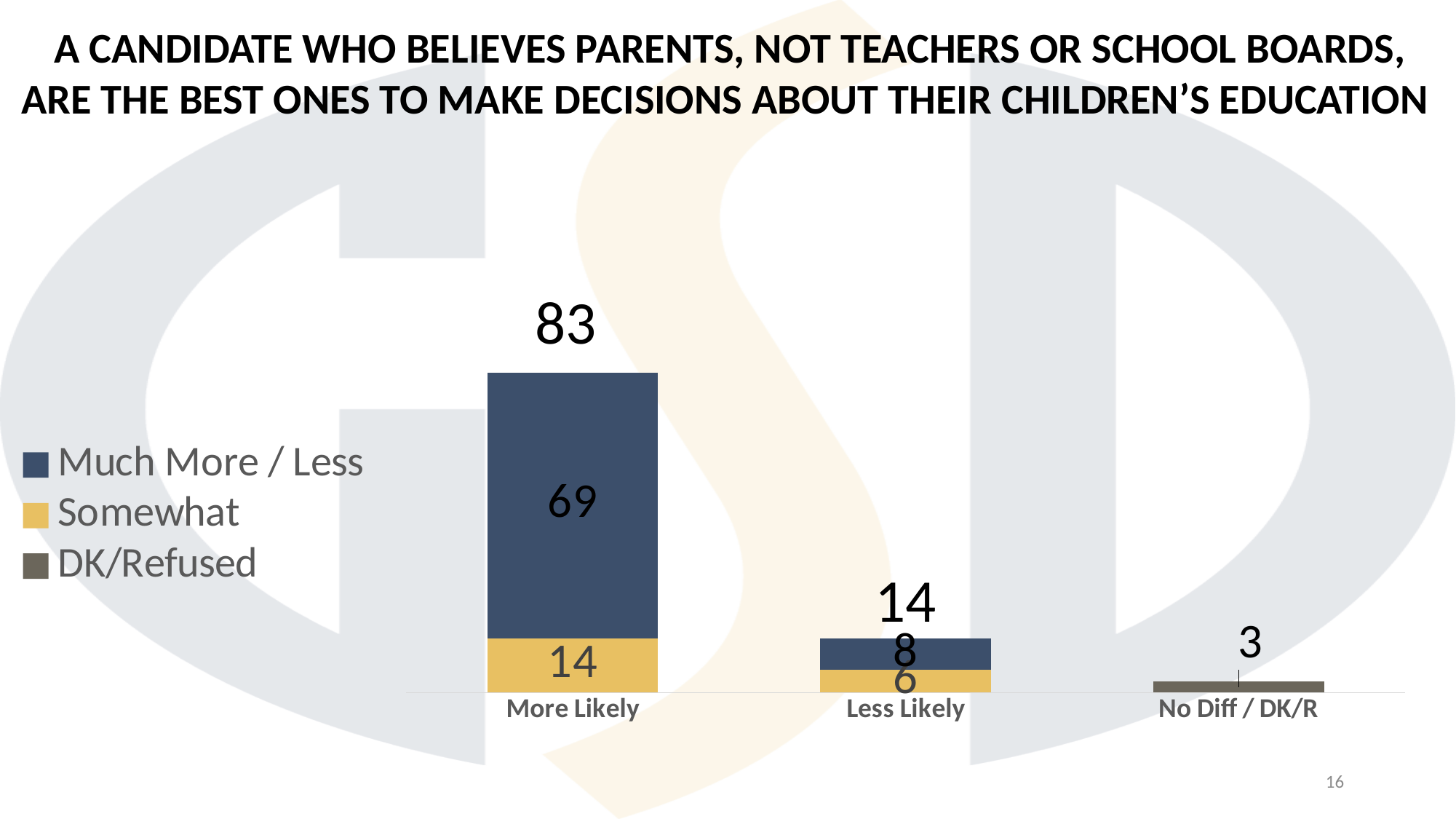
What is the 'Somewhat' value for the Less Likely bar? 6 Which category has the lowest total? No Diff / DK/R What is the 'Much More / Less' value for the Less Likely bar? 8 What is the 'Somewhat' value for the More Likely bar? 14 Which category has the highest total? More Likely How many series does the legend list? 3 What is the difference between the More Likely total and the Less Likely total? 69 What is the 'Much More / Less' value for the More Likely bar? 69 What is the total shown above the Less Likely stacked bar? 14 What kind of chart is shown on the slide? Stacked bar chart What is the value shown for No Diff / DK/R? 3 What is the total shown above the More Likely stacked bar? 83